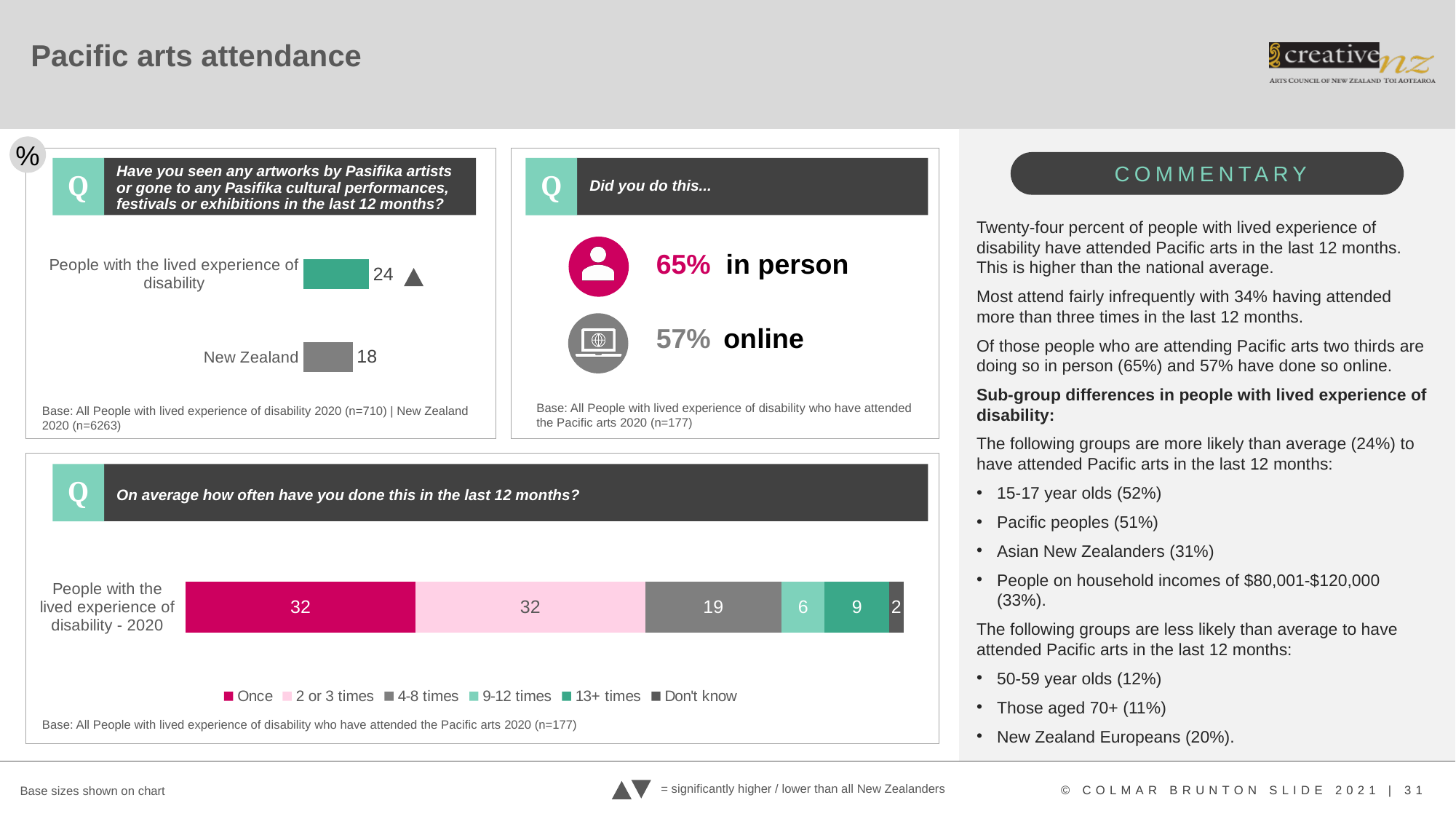
In the top-left chart on whether people have seen artworks by Pasifika artists, how many categories are shown? 2 In the bottom chart on how often people have done this in the last 12 months, what is the value for 9-12 times? 6 In the top-left chart on whether people have seen artworks by Pasifika artists, what is the difference between the value for People with the lived experience of disability and the value for New Zealand? 6 In the bottom chart on how often people have done this in the last 12 months, is the value for 13+ times larger or smaller than the value for 9-12 times? Larger In the bottom chart on how often people have done this in the last 12 months, what is the value for 4-8 times? 19 In the bottom chart on how often people have done this in the last 12 months, which series has the smallest value? Don't know In the bottom chart on how often people have done this in the last 12 months, what is the value for Once? 32 In the bottom chart on how often people have done this in the last 12 months, how many series does the legend list? 6 In the top-left chart on whether people have seen artworks by Pasifika artists, what is the value for People with the lived experience of disability? 24 In the top-left chart on whether people have seen artworks by Pasifika artists, which category has the higher value? People with the lived experience of disability What kind of chart is the bottom chart on how often people have done this in the last 12 months? Stacked bar chart In the top-left chart on whether people have seen artworks by Pasifika artists, what is the value for New Zealand? 18